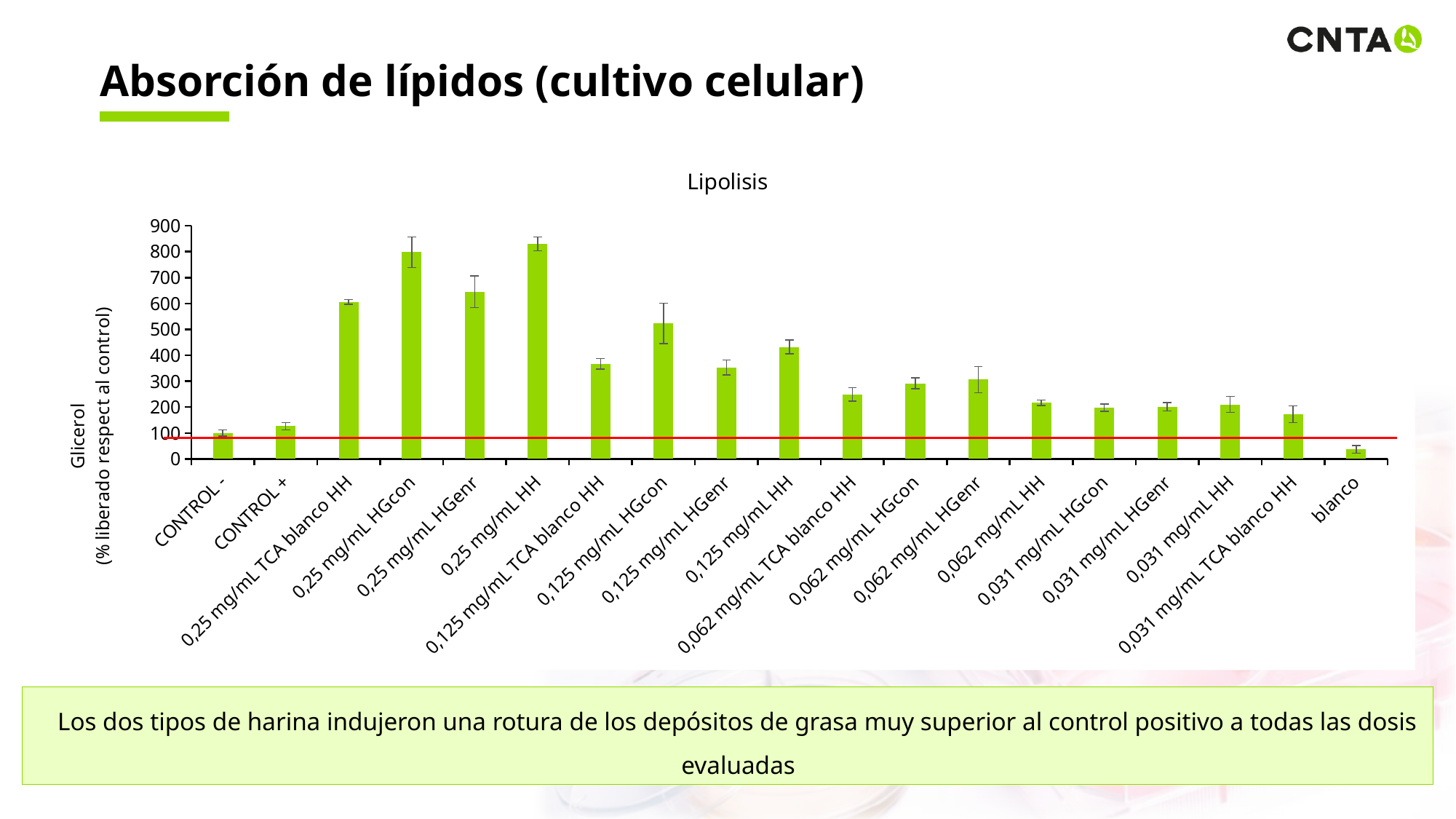
Which is larger, the value for 0,25 mg/mL HGcon or the value for 0,125 mg/mL HGcon? 0,25 mg/mL HGcon Is the value for 0,062 mg/mL TCA blanco HH greater or less than 300? less Which is larger, the value for 0,125 mg/mL HH or the value for 0,062 mg/mL HH? 0,125 mg/mL HH Which category has the lowest value in the chart? blanco Is the value for CONTROL + greater or less than 200? less Is the value for 0,25 mg/mL HGcon greater or less than 700? greater How many categories (bars) are plotted on the x axis of the chart? 19 What kind of chart is shown on the slide? bar chart What is the label of the y axis of the chart? Glicerol (% liberado respect al control) What is the title of the chart? Lipolisis